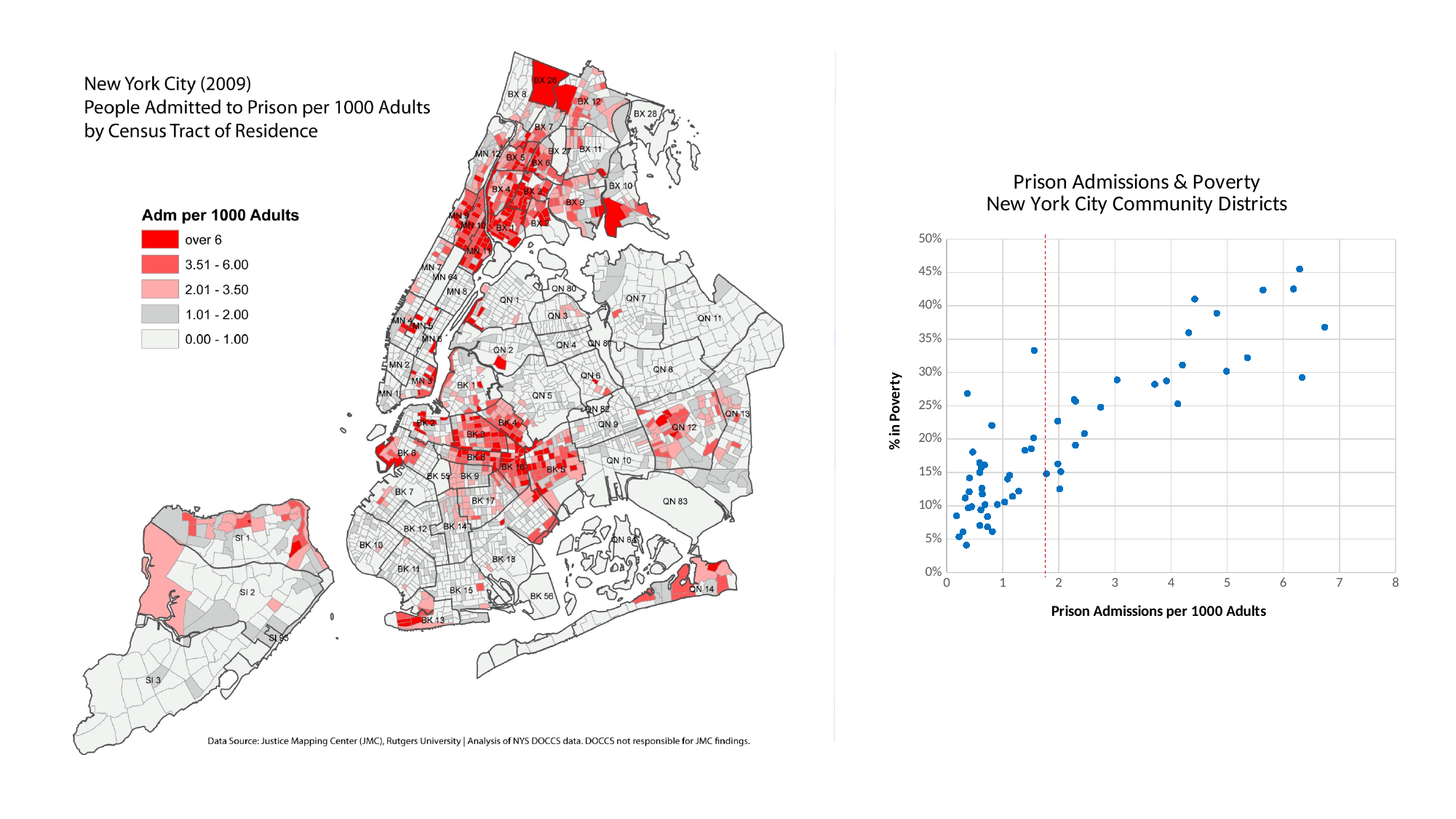
How many categories does the 'Adm per 1000 Adults' legend on the map list? 5 What is the label of the x axis in the 'Prison Admissions & Poverty' chart? Prison Admissions per 1000 Adults In the 'Prison Admissions & Poverty' chart, is the highest % in poverty plotted greater or less than 40%? greater In the 'Prison Admissions & Poverty' chart, does % in poverty generally rise or fall as prison admissions per 1000 adults increase? rise In the 'Prison Admissions & Poverty' chart, is the lowest % in poverty plotted greater or less than 5%? less What kind of chart is the 'Prison Admissions & Poverty' chart on the right of the slide? scatter chart In the 'Prison Admissions & Poverty' chart, is the largest prison admissions per 1000 adults value plotted greater or less than 7? less What is the title of the chart on the right of the slide? Prison Admissions & Poverty New York City Community Districts